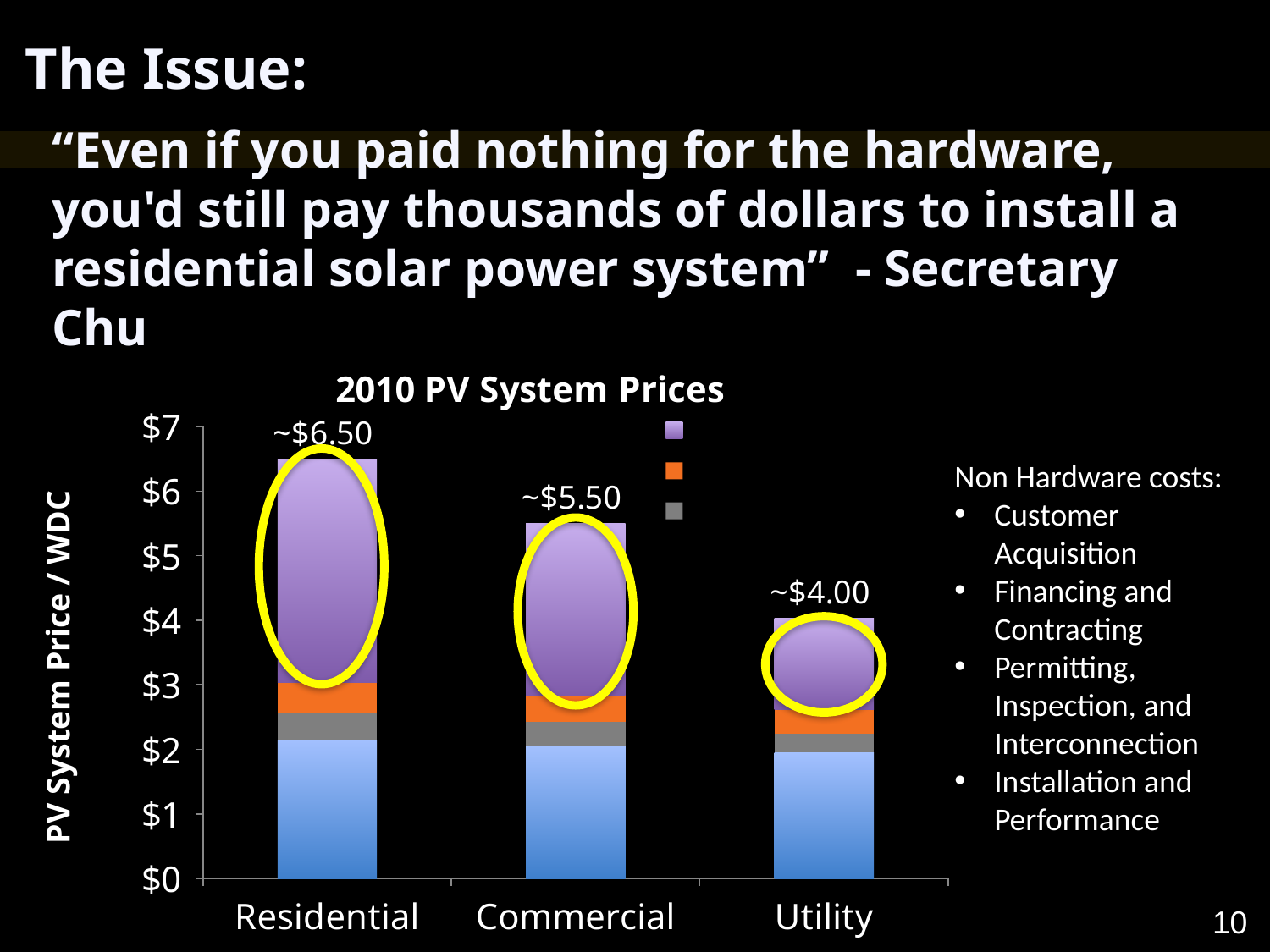
Is the total value for Commercial greater or less than $5? greater Is the total value for Utility greater or less than $5? less Do the total bar heights rise or fall moving from Residential to Utility along the x axis? fall Which has a higher total PV system price, Residential or Commercial? Residential Which has a higher total PV system price, Commercial or Utility? Commercial Which category has the highest total PV system price? Residential Is the total value for Residential greater or less than $6? greater Which category has the lowest total PV system price? Utility What kind of chart is shown on the slide? Stacked bar chart What is the title of the chart? 2010 PV System Prices How many categories are shown on the x axis of the chart? 3 What is the label on the vertical axis of the chart? PV System Price / WDC